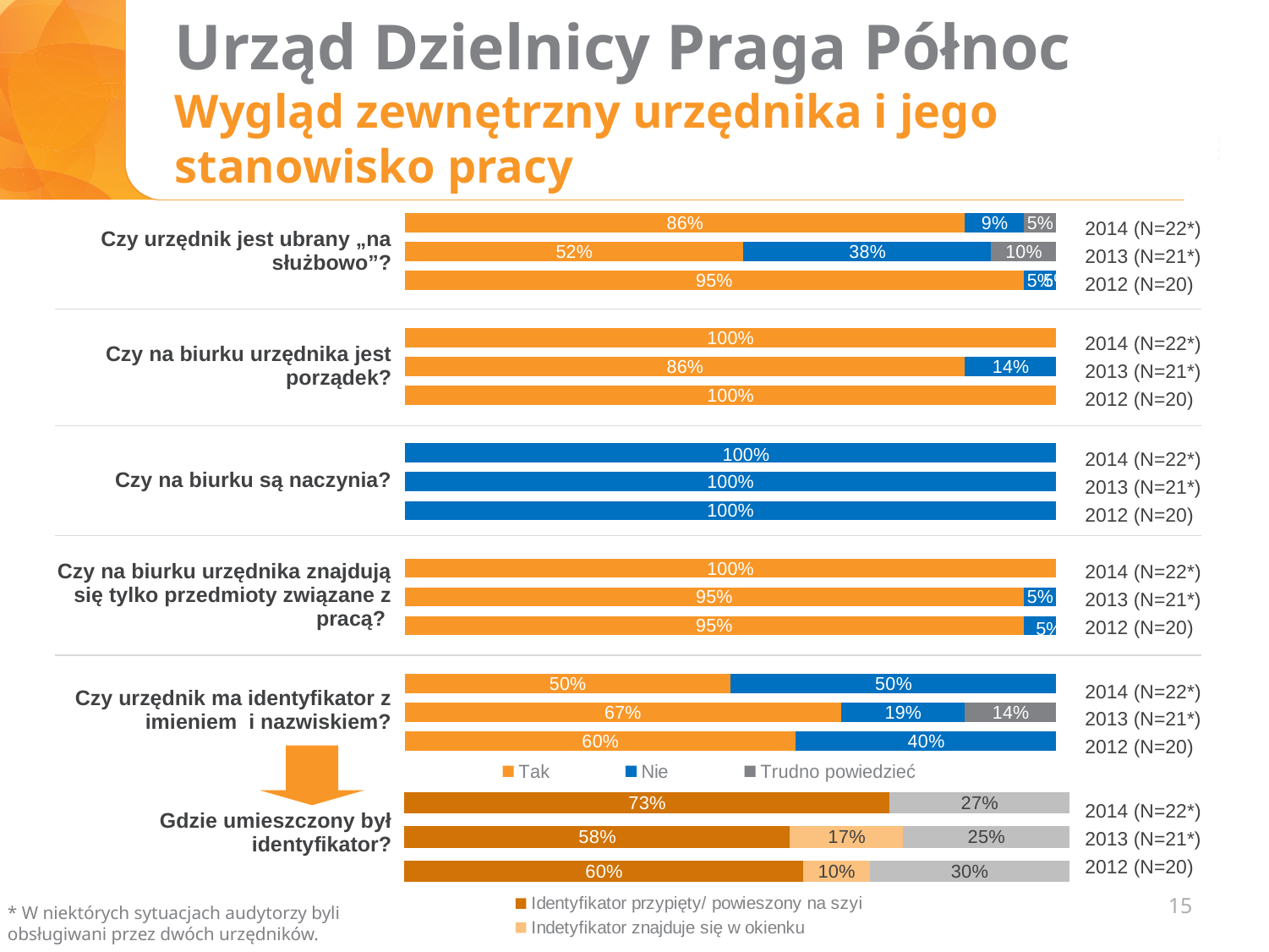
In the chart "Czy urzędnik jest ubrany „na służbowo”?", what percentage answered "Nie" in 2013 (N=21*)? 38% In the chart "Gdzie umieszczony był identyfikator?", what percentage had the identifier "przypięty/ powieszony na szyi" in 2014 (N=22*)? 73% In the chart "Czy urzędnik ma identyfikator z imieniem i nazwiskiem?", what percentage answered "Trudno powiedzieć" in 2013 (N=21*)? 14% In the chart "Czy na biurku są naczynia?", what percentage answered "Nie" in 2012 (N=20)? 100% In the chart "Czy na biurku urzędnika jest porządek?", what percentage answered "Nie" in 2013 (N=21*)? 14% In the chart "Czy urzędnik jest ubrany „na służbowo”?", which year has the lowest "Tak" share? 2013 (N=21*) What kind of chart is used on this slide? Stacked bar chart In the chart "Czy urzędnik ma identyfikator z imieniem i nazwiskiem?", which is larger: the "Tak" share in 2013 (N=21*) or in 2012 (N=20)? 2013 (N=21*) In the chart "Czy urzędnik jest ubrany „na służbowo”?", what percentage answered "Tak" in 2014 (N=22*)? 86% In the chart "Gdzie umieszczony był identyfikator?", what percentage had the identifier "w okienku" in 2013 (N=21*)? 17% In the chart "Czy na biurku urzędnika znajdują się tylko przedmioty związane z pracą?", what is the difference between the "Tak" share in 2014 (N=22*) and in 2013 (N=21*)? 5% How many series does the legend with "Tak", "Nie" and "Trudno powiedzieć" list? 3